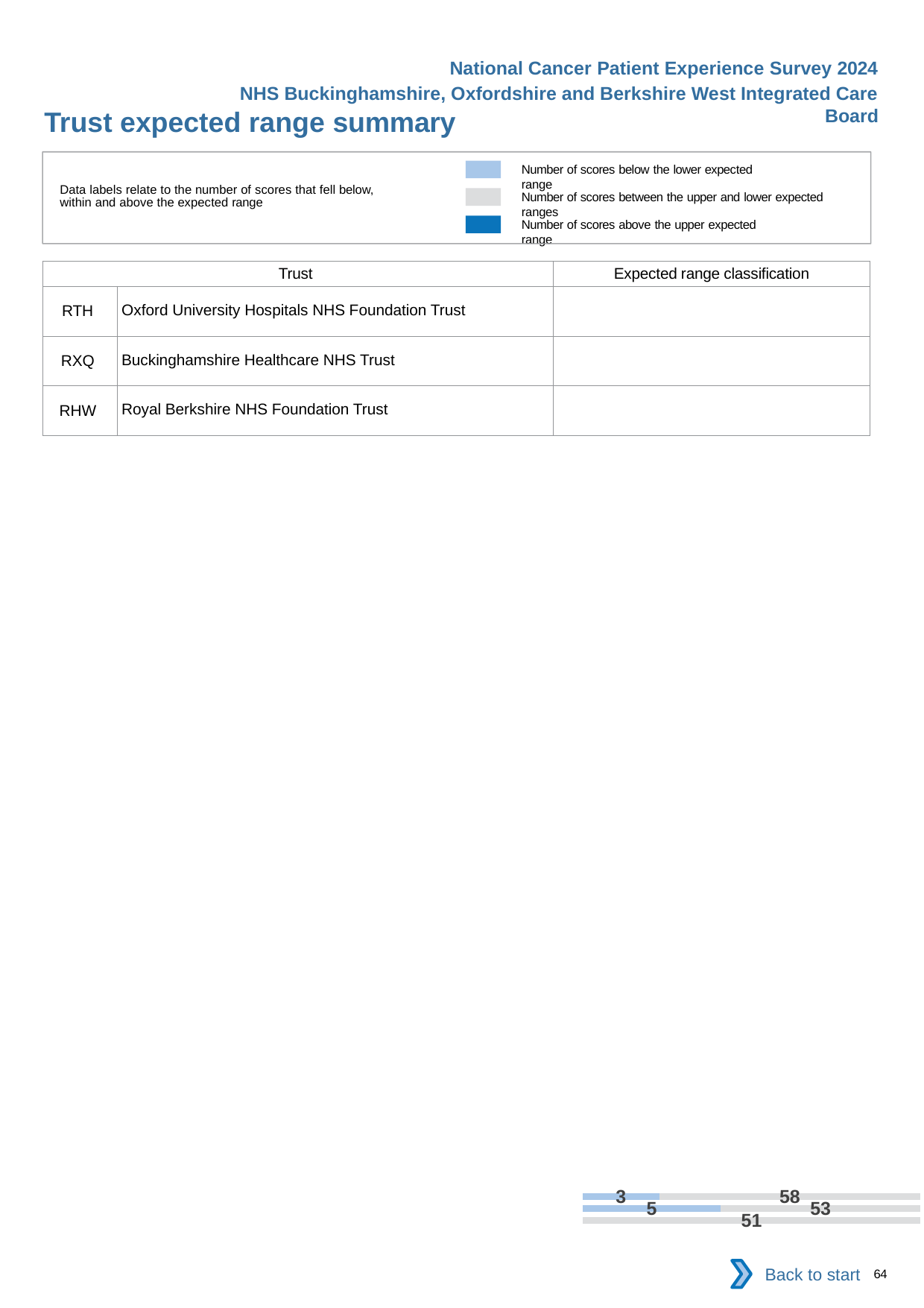
In the small bar chart at the bottom right, what is the value labelled on the bottom bar? 51 In the small bar chart at the bottom right, how many bars are plotted? 3 In the small bar chart at the bottom right, what is the difference between the grey segment of the top bar (58) and the grey segment of the middle bar (53)? 5 According to the legend box on the slide, which colour represents the number of scores below the lower expected range? light blue In the small bar chart at the bottom right, what is the total of the top bar (3 and 58)? 61 In the small bar chart at the bottom right, what is the value of the grey segment of the top bar? 58 In the small bar chart at the bottom right, what is the value of the light blue segment of the top bar? 3 In the small bar chart at the bottom right, what is the total of the middle bar (5 and 53)? 58 In the small bar chart at the bottom right, what is the value of the grey segment of the middle bar? 53 In the small bar chart at the bottom right, which is larger: the light blue segment of the top bar or the light blue segment of the middle bar? the middle bar (5) What kind of chart is the small chart at the bottom right of the slide? bar chart In the small bar chart at the bottom right, what is the value of the light blue segment of the middle bar? 5